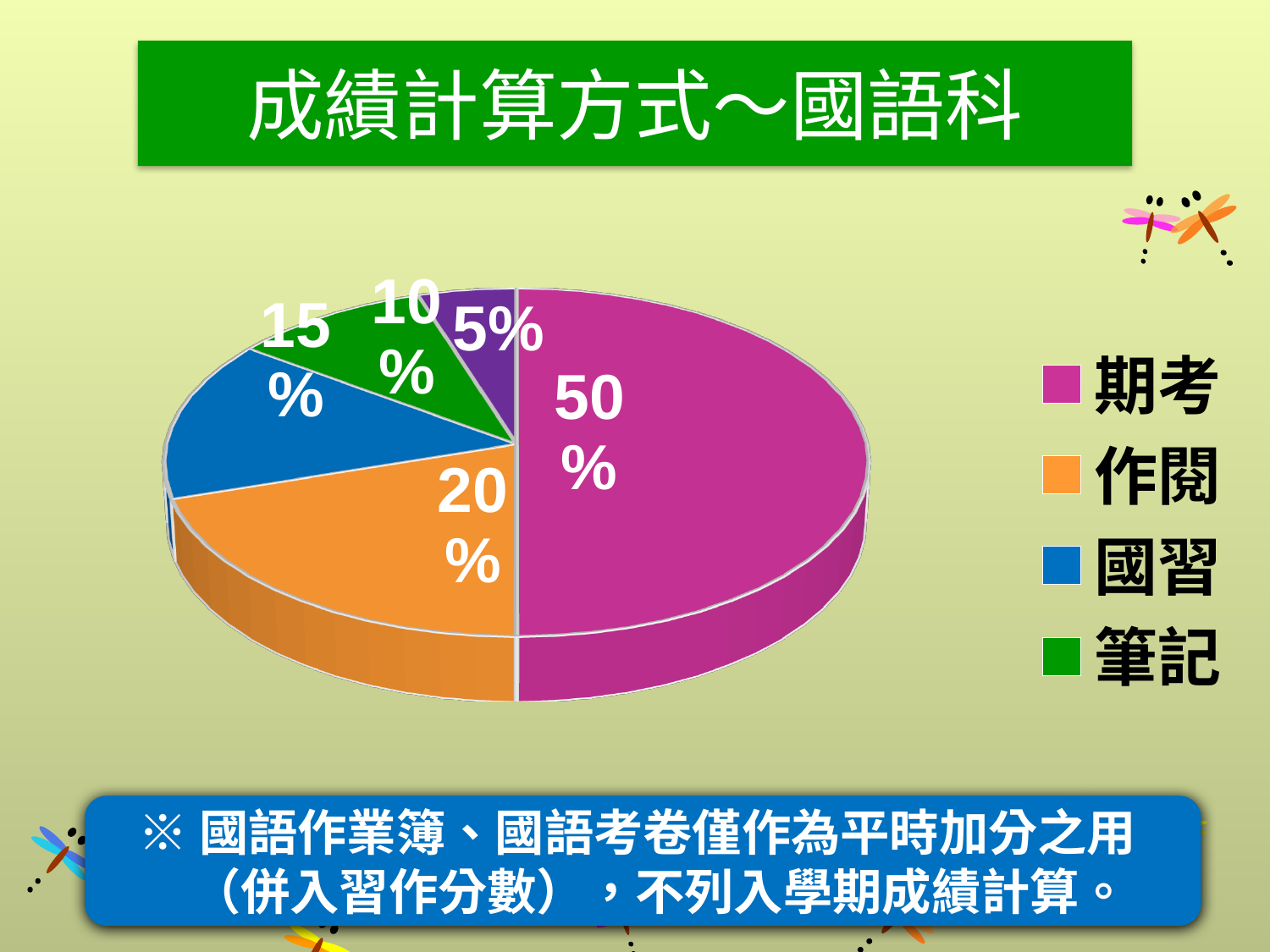
What is the difference between the 國習 and 筆記 percentages in the pie chart? 5% How many slices does the pie chart have? 5 What percentage does the 國習 slice represent in the pie chart? 15% What percentage does the 期考 slice represent in the pie chart? 50% Which category has the largest slice in the pie chart? 期考 What is the title of the slide containing the pie chart? 成績計算方式～國語科 What percentage does the 筆記 slice represent in the pie chart? 10% What percentage does the 作閱 slice represent in the pie chart? 20% How many entries does the legend of the pie chart list? 4 What kind of chart is shown on the slide? pie chart Which is larger in the pie chart, 作閱 or 國習? 作閱 What is the difference between the 期考 and 作閱 percentages in the pie chart? 30%